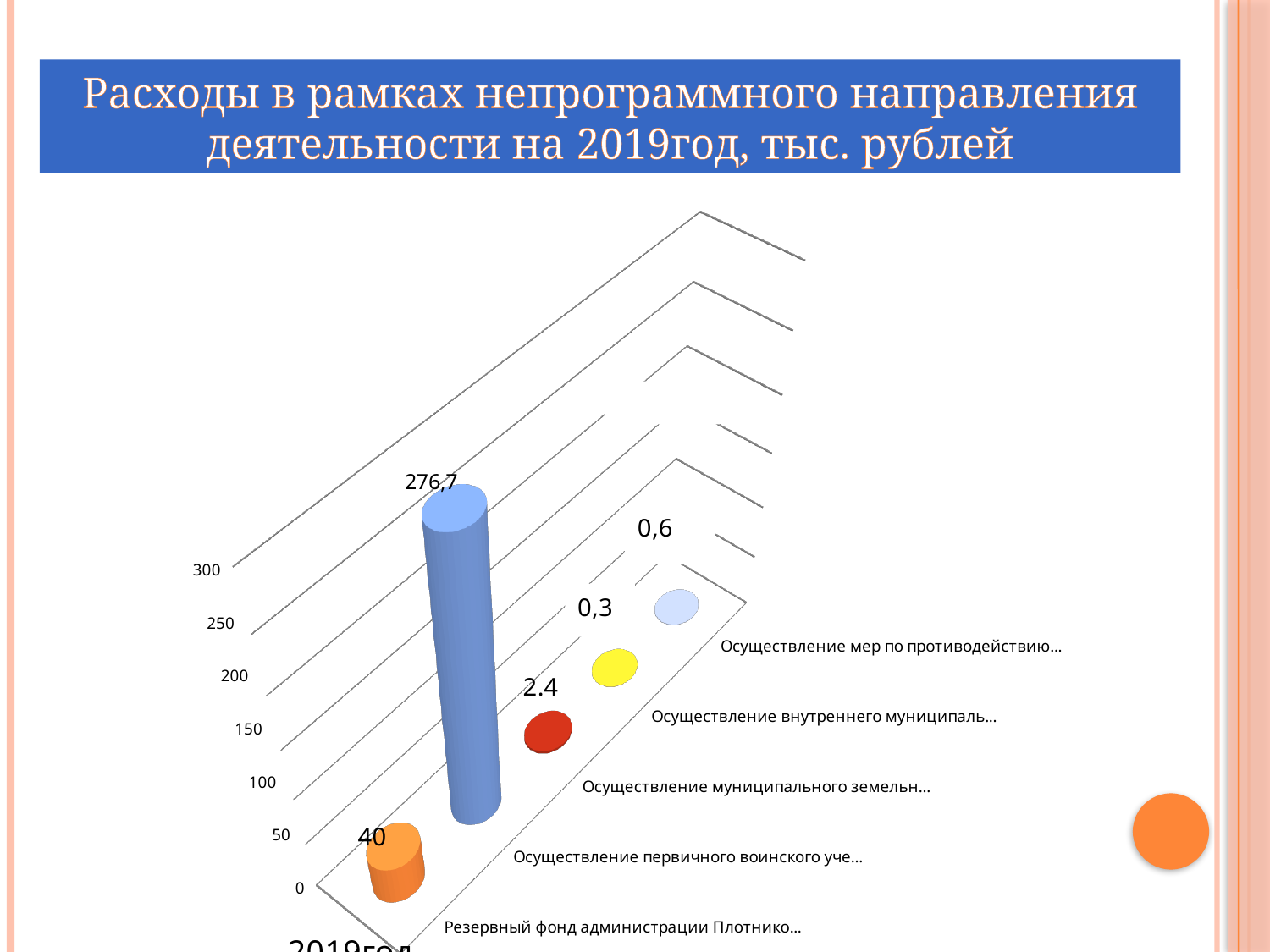
Which category has the lowest value? Осуществление внутреннего муниципаль… What kind of chart is shown on the slide? bar chart Which is larger: the value for Резервный фонд администрации Плотнико… or the value for Осуществление муниципального земельн…? Резервный фонд администрации Плотнико… What is the value for Осуществление первичного воинского уче…? 276,7 What is the value for Резервный фонд администрации Плотнико…? 40 What is the title of the chart on the slide? Расходы в рамках непрограммного направления деятельности на 2019год, тыс. рублей How many categories are plotted in the chart? 5 What is the value for Осуществление мер по противодействию…? 0,6 Which category has the highest value? Осуществление первичного воинского уче… What is the value for Осуществление муниципального земельн…? 2.4 Is the value for Осуществление первичного воинского уче… greater or less than 250? greater What is the value for Осуществление внутреннего муниципаль…? 0,3